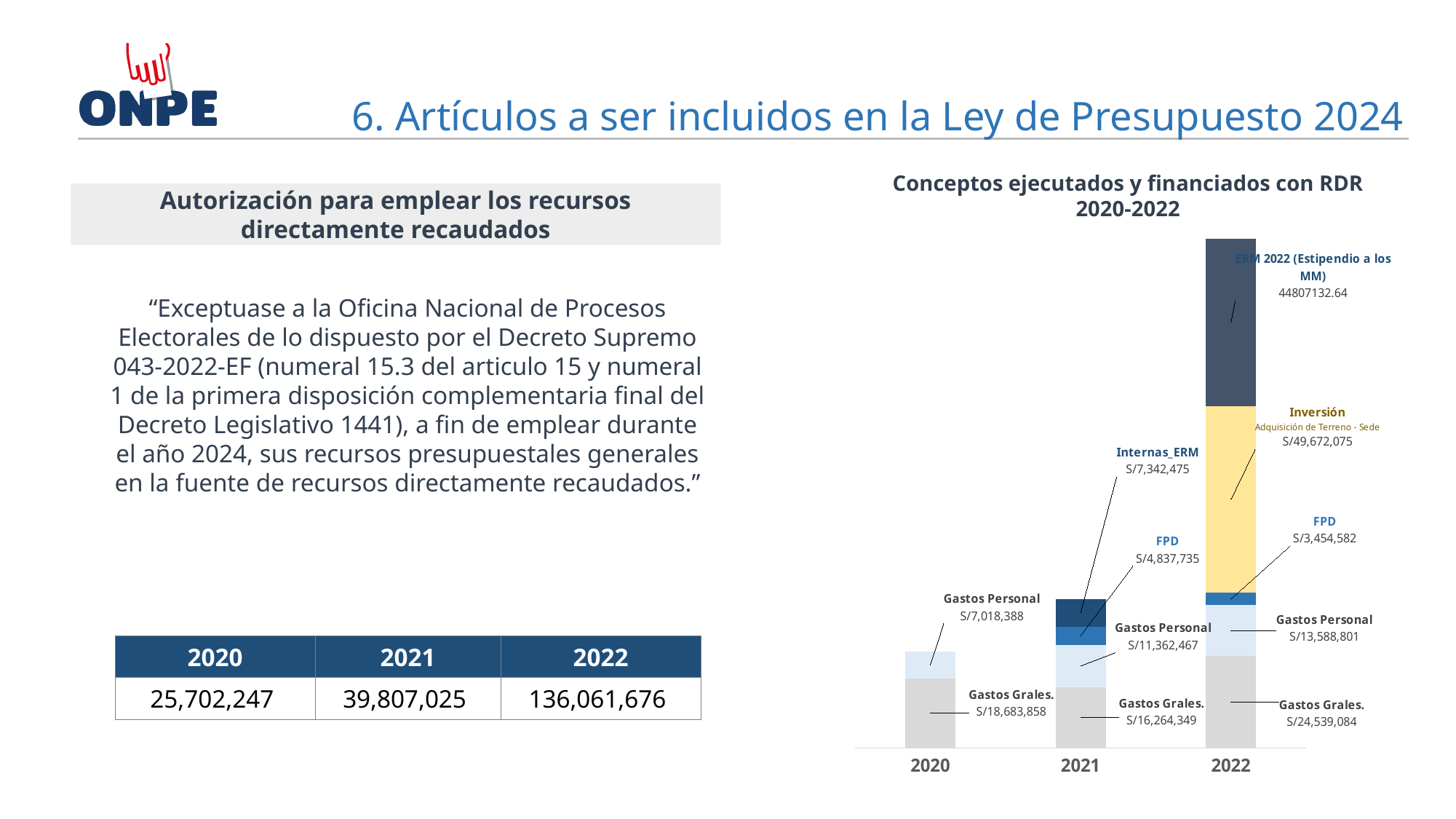
Which year has the tallest stacked bar in the chart? 2022 What is the value of Gastos Personal for 2021 in the chart? S/11,362,467 What is the value of Gastos Grales. for 2020 in the chart? S/18,683,858 What is the difference between Gastos Grales. in 2022 and Gastos Grales. in 2020? S/5,855,226 Do the stacked bar heights rise or fall from 2020 to 2022? Rise What is the value of Inversión (Adquisición de Terreno - Sede) for 2022 in the chart? S/49,672,075 How many years are shown on the x axis of the chart? 3 What is the title of the chart on the slide? Conceptos ejecutados y financiados con RDR 2020-2022 Which is larger, FPD in 2021 or FPD in 2022? FPD in 2021 What kind of chart is shown under the title 'Conceptos ejecutados y financiados con RDR 2020-2022'? Stacked bar chart What is the value of Internas_ERM for 2021 in the chart? S/7,342,475 Which year has the shortest stacked bar in the chart? 2020